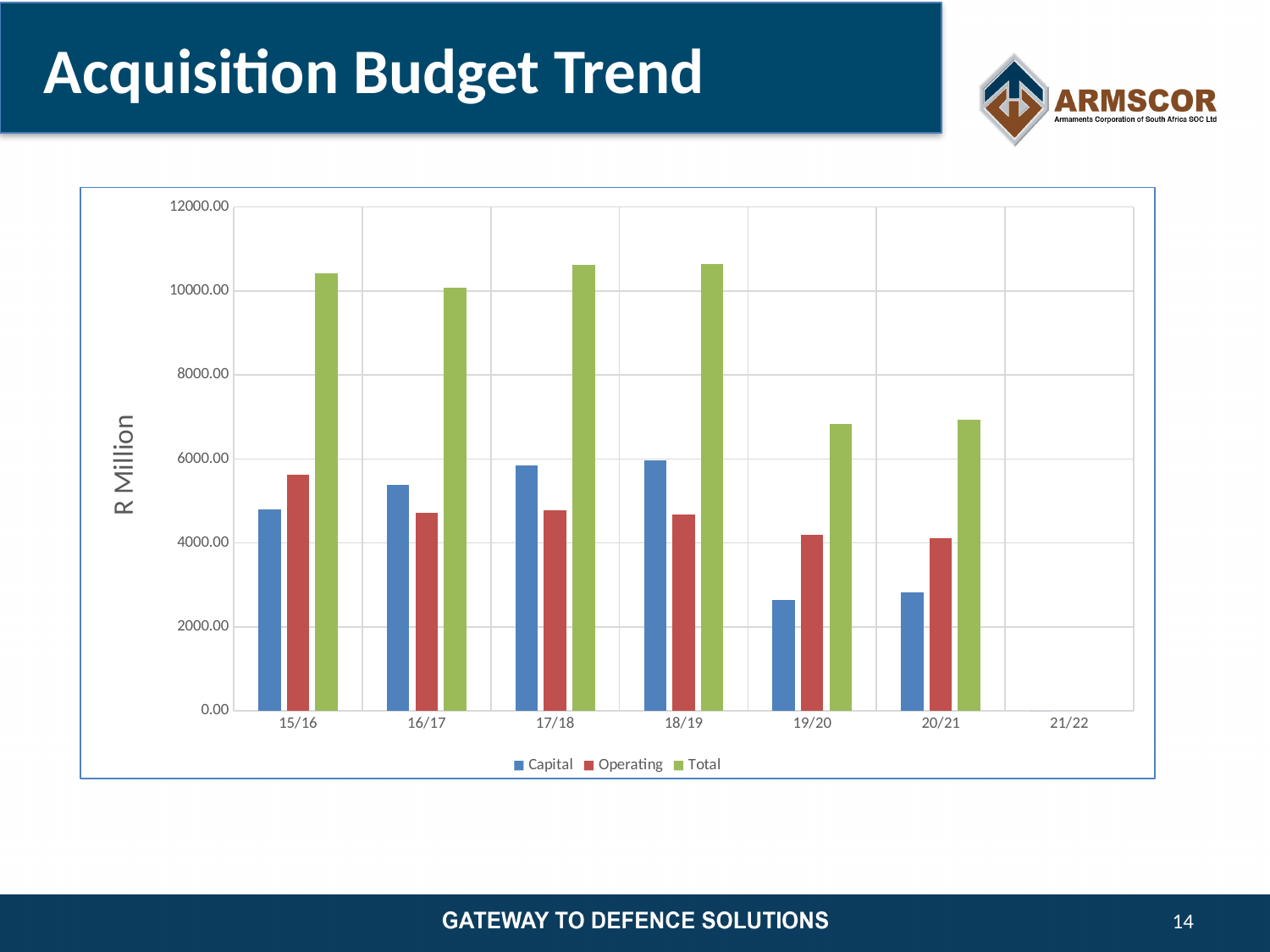
Does the Capital value rise or fall from 15/16 to 18/19? rise Which year has the highest Operating value? 15/16 How many series does the legend list? 3 In 17/18, which is larger, Capital or Operating? Capital Is the Total value for 19/20 greater or less than 8000.00? less Is the Capital value for 19/20 greater or less than 2000.00? greater How many categories are shown on the x axis? 7 What is the label on the vertical axis? R Million In 15/16, which is larger, Capital or Operating? Operating What kind of chart is shown on the slide? bar chart Is the Total value for 15/16 greater or less than 10000.00? greater